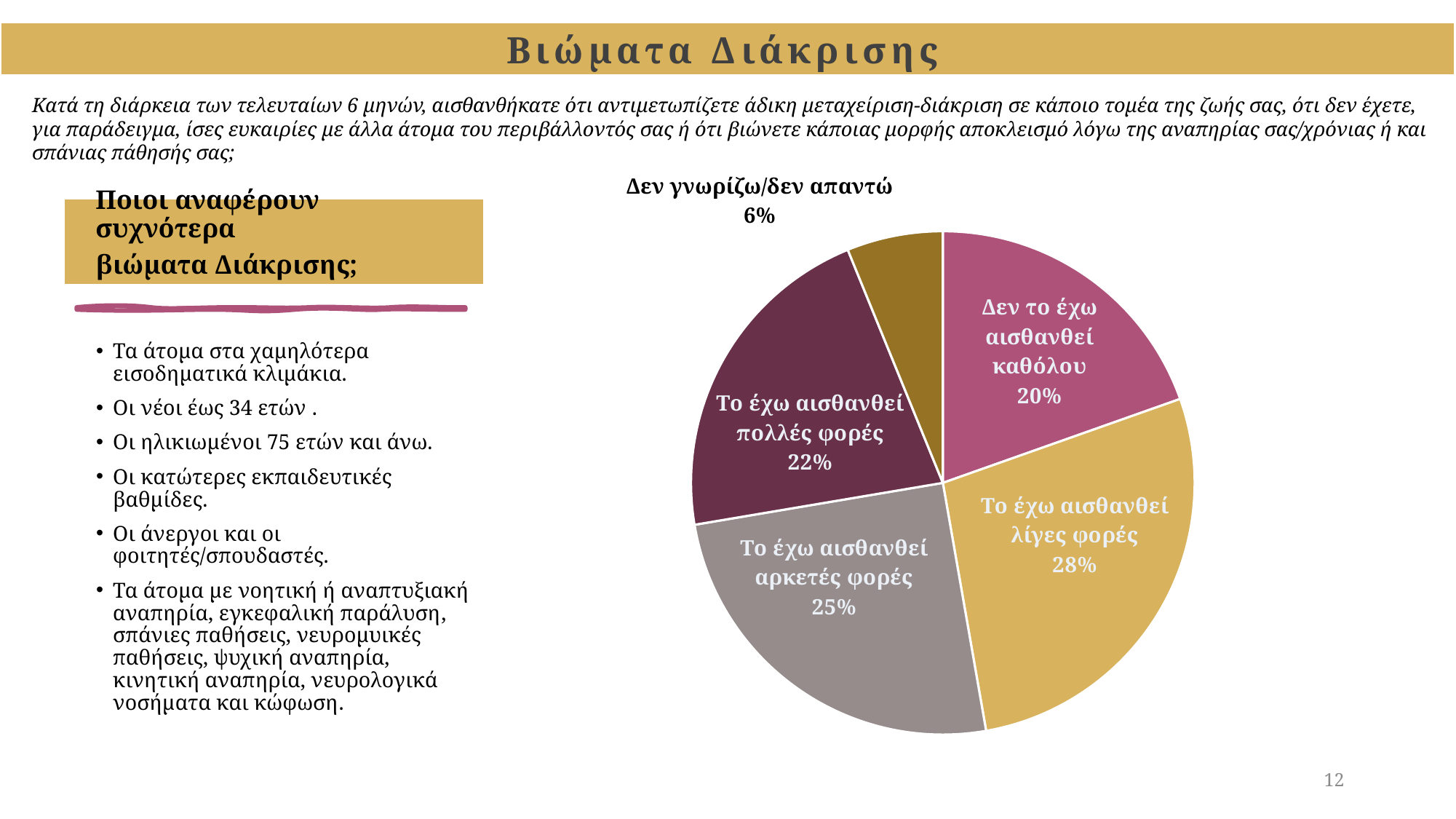
Which is larger: "Το έχω αισθανθεί αρκετές φορές" or "Δεν το έχω αισθανθεί καθόλου"? Το έχω αισθανθεί αρκετές φορές What is the value shown for "Δεν το έχω αισθανθεί καθόλου"? 20% What share of the pie is "Το έχω αισθανθεί λίγες φορές"? 28% What is the combined share of "Το έχω αισθανθεί πολλές φορές" and "Δεν γνωρίζω/δεν απαντώ"? 28% Which slice of the pie chart is the largest? Το έχω αισθανθεί λίγες φορές What is the value shown for "Το έχω αισθανθεί αρκετές φορές"? 25% What colour is the slice for "Το έχω αισθανθεί λίγες φορές"? gold/yellow What is the difference between "Το έχω αισθανθεί λίγες φορές" and "Το έχω αισθανθεί πολλές φορές"? 6% What kind of chart is shown on the slide? pie chart What is the value shown for "Δεν γνωρίζω/δεν απαντώ"? 6% How many slices does the pie chart have? 5 Which slice of the pie chart is the smallest? Δεν γνωρίζω/δεν απαντώ